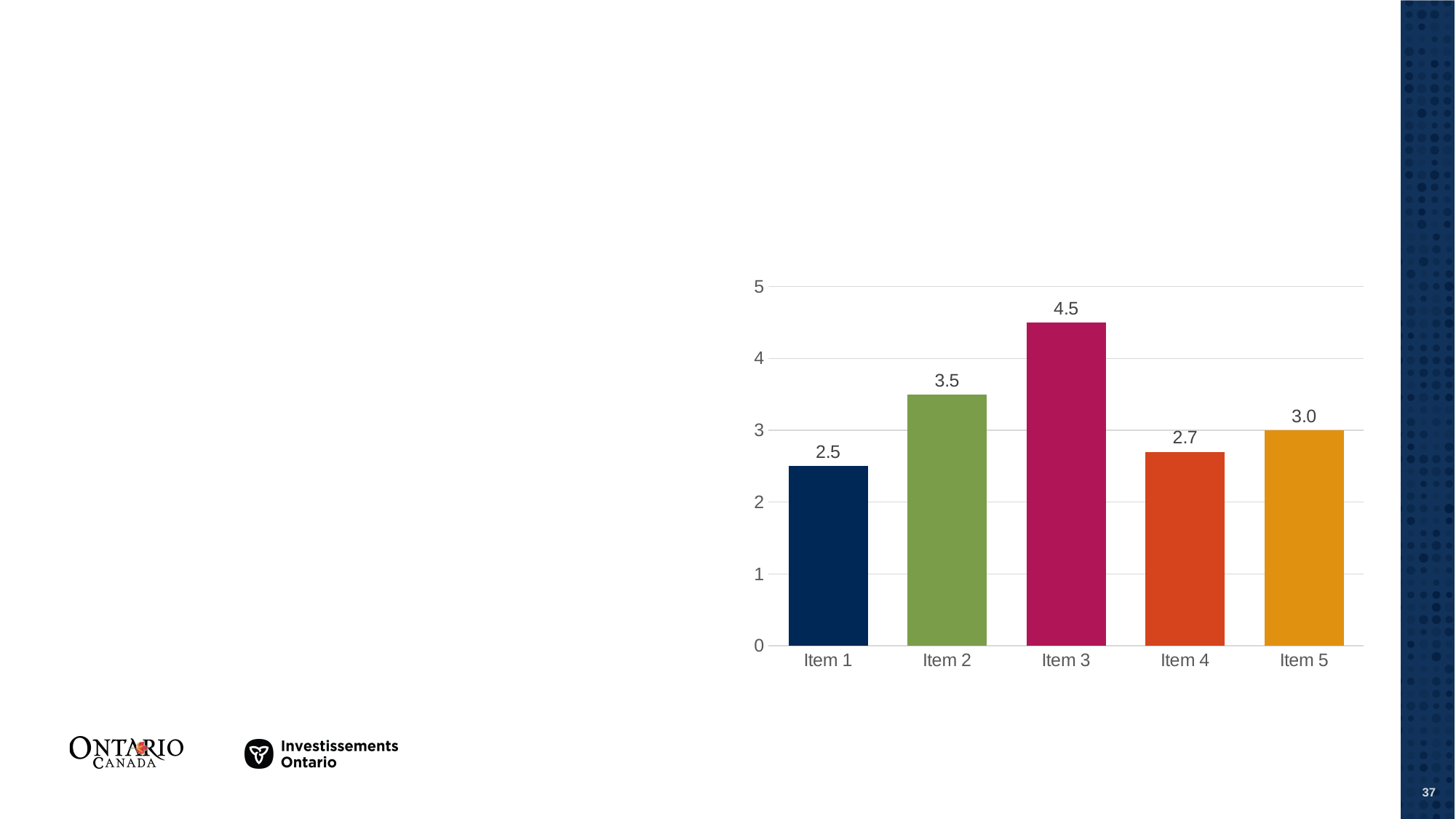
Which item has the highest value? Item 3 What is the value for Item 5? 3.0 Is the value for Item 4 greater or less than 3? less What kind of chart is shown on the slide? bar chart What colour is the bar for Item 3? magenta What is the value for Item 1? 2.5 Which is larger, the value for Item 2 or the value for Item 4? Item 2 Which item has the lowest value? Item 1 What is the value for Item 3? 4.5 What is the difference between the values for Item 3 and Item 2? 1.0 What is the difference between the values for Item 5 and Item 4? 0.3 How many items are shown on the x axis? 5